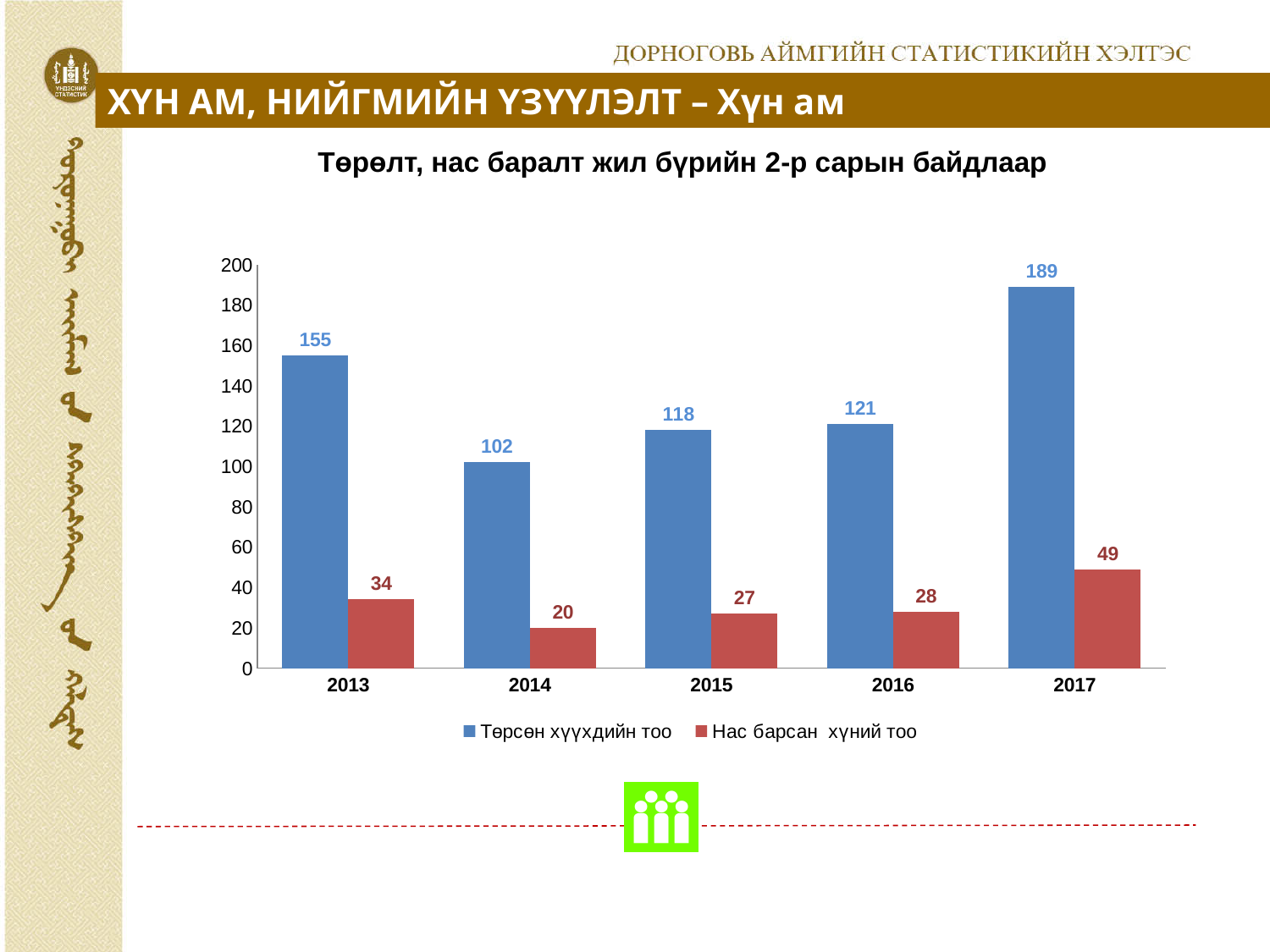
What kind of chart is shown on the slide? bar chart What is the value of Нас барсан хүний тоо for 2017? 49 Is the value of Төрсөн хүүхдийн тоо for 2015 greater or less than 100? greater Which is larger: Нас барсан хүний тоо in 2013 or in 2016? 2013 What is the difference between Төрсөн хүүхдийн тоо in 2017 and in 2016? 68 Does Төрсөн хүүхдийн тоо rise or fall from 2014 to 2017? rise What is the value of Төрсөн хүүхдийн тоо for 2013? 155 Which year has the lowest value for Нас барсан хүний тоо? 2014 How many series does the legend list? 2 What colour are the bars for Нас барсан хүний тоо? red Which year has the highest value for Төрсөн хүүхдийн тоо? 2017 How many years are shown on the x axis? 5